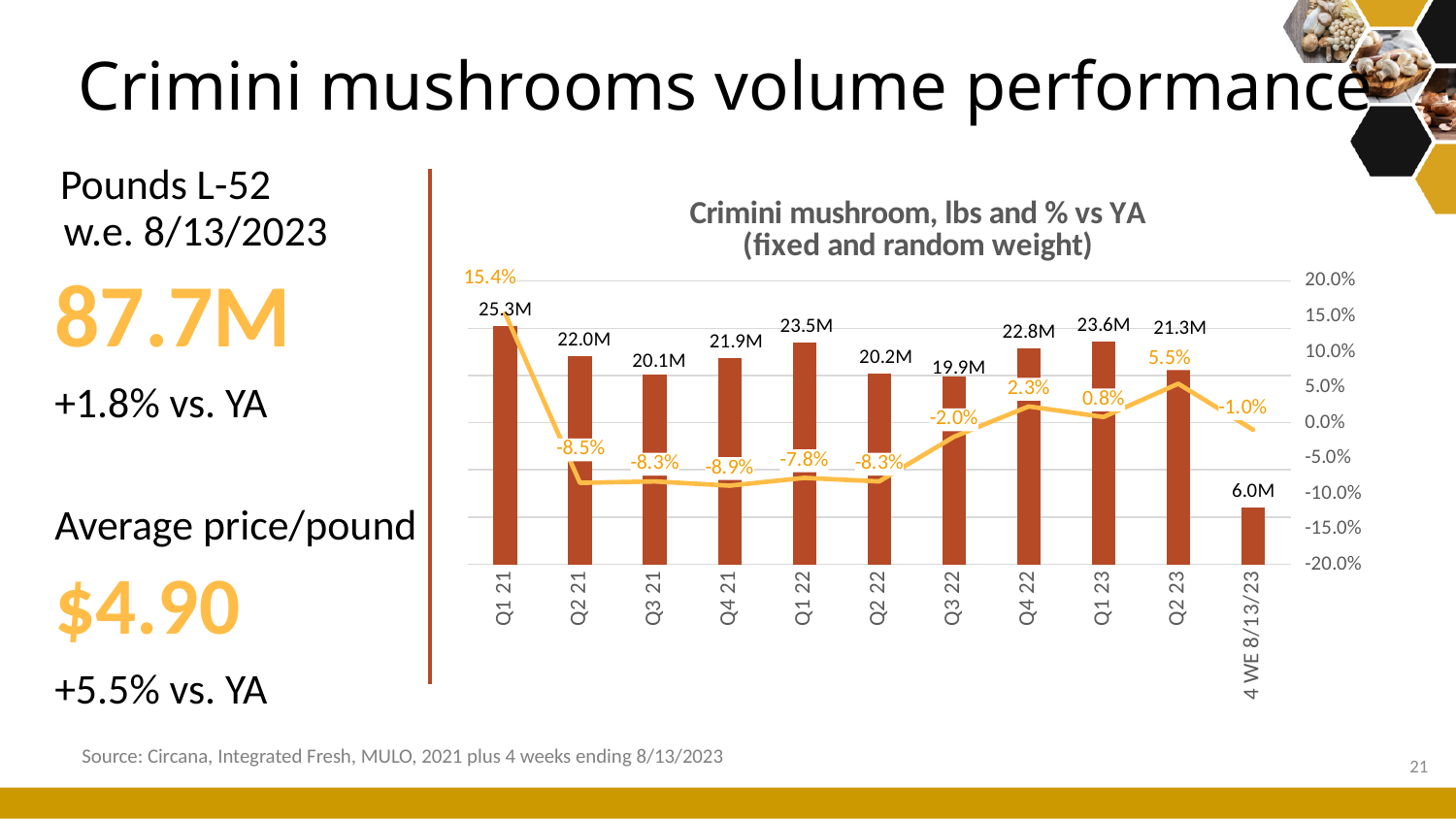
What is the % vs YA value for Q2 23? 5.5% Does the % vs YA line rise or fall from Q3 22 to Q4 22? Rise Which period has the highest pounds value? Q1 21 What is the pounds value for Q1 21? 25.3M What is the % vs YA value for Q4 21? -8.9% What is the pounds value for the 4 WE 8/13/23 period? 6.0M What is the title of the chart? Crimini mushroom, lbs and % vs YA (fixed and random weight) What kind of chart is this? Combined bar and line chart What is the difference in pounds between Q1 23 and Q2 23? 2.3M Which has the larger pounds value, Q3 22 or Q4 22? Q4 22 Which period has the lowest % vs YA value? Q4 21 How many periods are shown on the x axis? 11